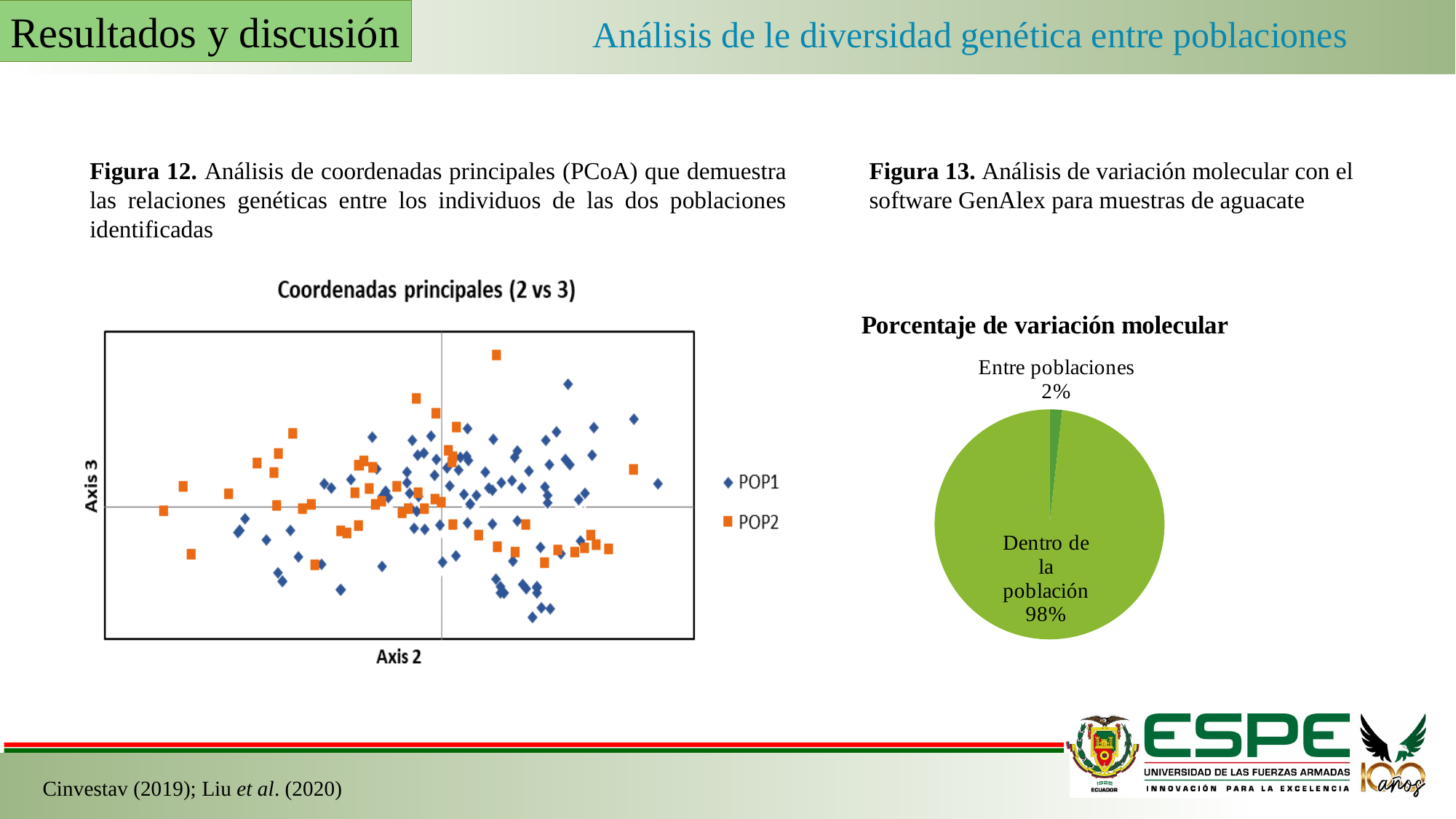
In the pie chart titled "Porcentaje de variación molecular", how many slices are there? 2 In the chart titled "Coordenadas principales (2 vs 3)", how many series does the legend list? 2 What kind of chart is the one titled "Porcentaje de variación molecular"? Pie chart In the pie chart titled "Porcentaje de variación molecular", which slice is the smallest? Entre poblaciones In the pie chart titled "Porcentaje de variación molecular", which slice is the largest? Dentro de la población In the chart titled "Coordenadas principales (2 vs 3)", what are the two series named in the legend? POP1 and POP2 In the pie chart titled "Porcentaje de variación molecular", what share is labelled "Dentro de la población"? 98% In the pie chart titled "Porcentaje de variación molecular", what share is labelled "Entre poblaciones"? 2% In the pie chart titled "Porcentaje de variación molecular", what is the difference between the "Dentro de la población" share and the "Entre poblaciones" share? 96% In the chart titled "Coordenadas principales (2 vs 3)", what is the label of the horizontal axis? Axis 2 What kind of chart is the one titled "Coordenadas principales (2 vs 3)"? Scatter plot In the pie chart titled "Porcentaje de variación molecular", which is larger: "Entre poblaciones" or "Dentro de la población"? Dentro de la población